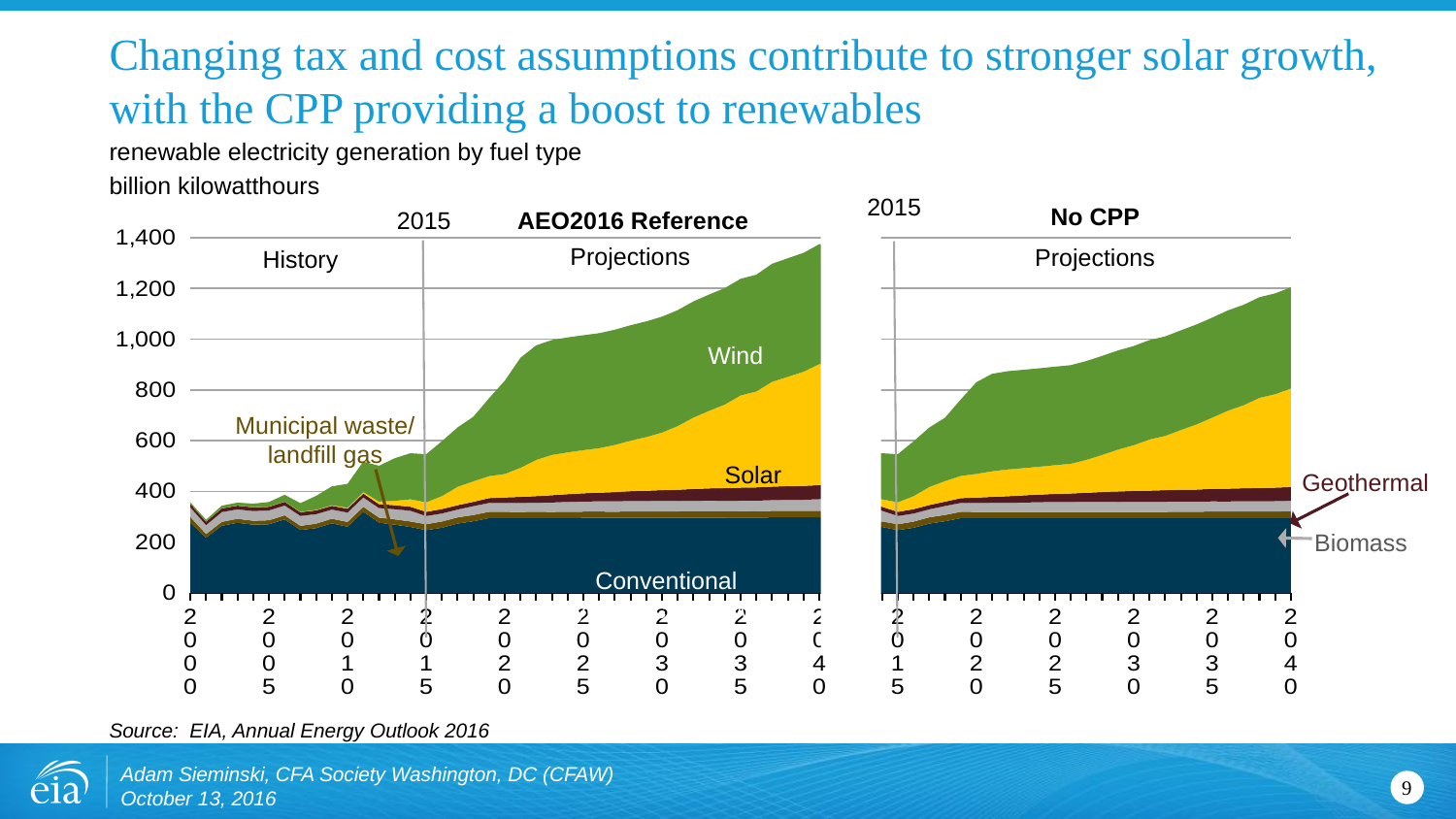
In the AEO2016 Reference chart, is the total renewable generation in 2000 greater or less than 400 billion kilowatthours? less In the AEO2016 Reference chart, is the total renewable generation in 2015 greater or less than 400 billion kilowatthours? greater Which chart shows higher total renewable generation in 2040, AEO2016 Reference or No CPP? AEO2016 Reference In the No CPP chart, is the total renewable generation in 2040 greater or less than 1,400 billion kilowatthours? less In the AEO2016 Reference chart, which year does the vertical line separating History from Projections mark? 2015 What kind of chart is used on this slide for the AEO2016 Reference and No CPP panels? stacked area chart How many fuel types are labeled across the charts on this slide? 6 What unit of measurement is used for the y axis of the charts? billion kilowatthours In the No CPP chart, does total renewable generation rise or fall from 2015 to 2040? rise In the AEO2016 Reference chart, which is larger in 2040, the Solar band or the Conventional band? Solar Which fuel type forms the bottom layer of the stacked areas in both charts? Conventional